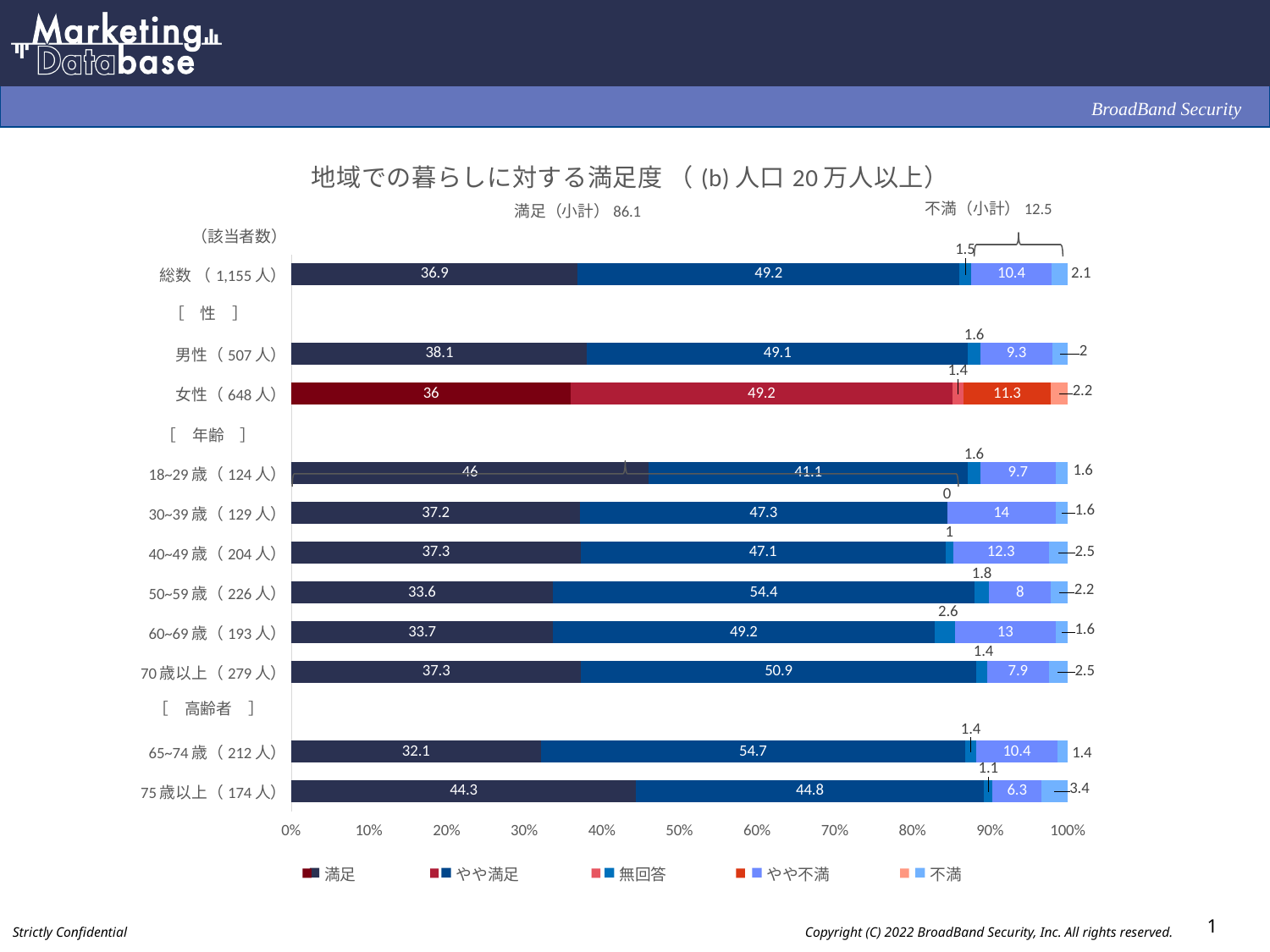
What is the 満足（小計） value shown above the chart? 86.1 What is the 不満 value for 75歳以上? 3.4 Which is larger, the やや満足 value for 50~59歳 or for 60~69歳? 50~59歳 What is the やや不満 value for 女性? 11.3 Which category has the lowest 満足 value? 65~74歳 What kind of chart is shown on the slide? Stacked bar chart What is the 無回答 value for 30~39歳? 0 Which category has the highest やや不満 value? 30~39歳 What is the difference between the 満足 values for 男性 and 女性? 2.1 What is the やや満足 value for 65~74歳? 54.7 What is the 満足 value for 18~29歳? 46 How many series does the legend list? 5